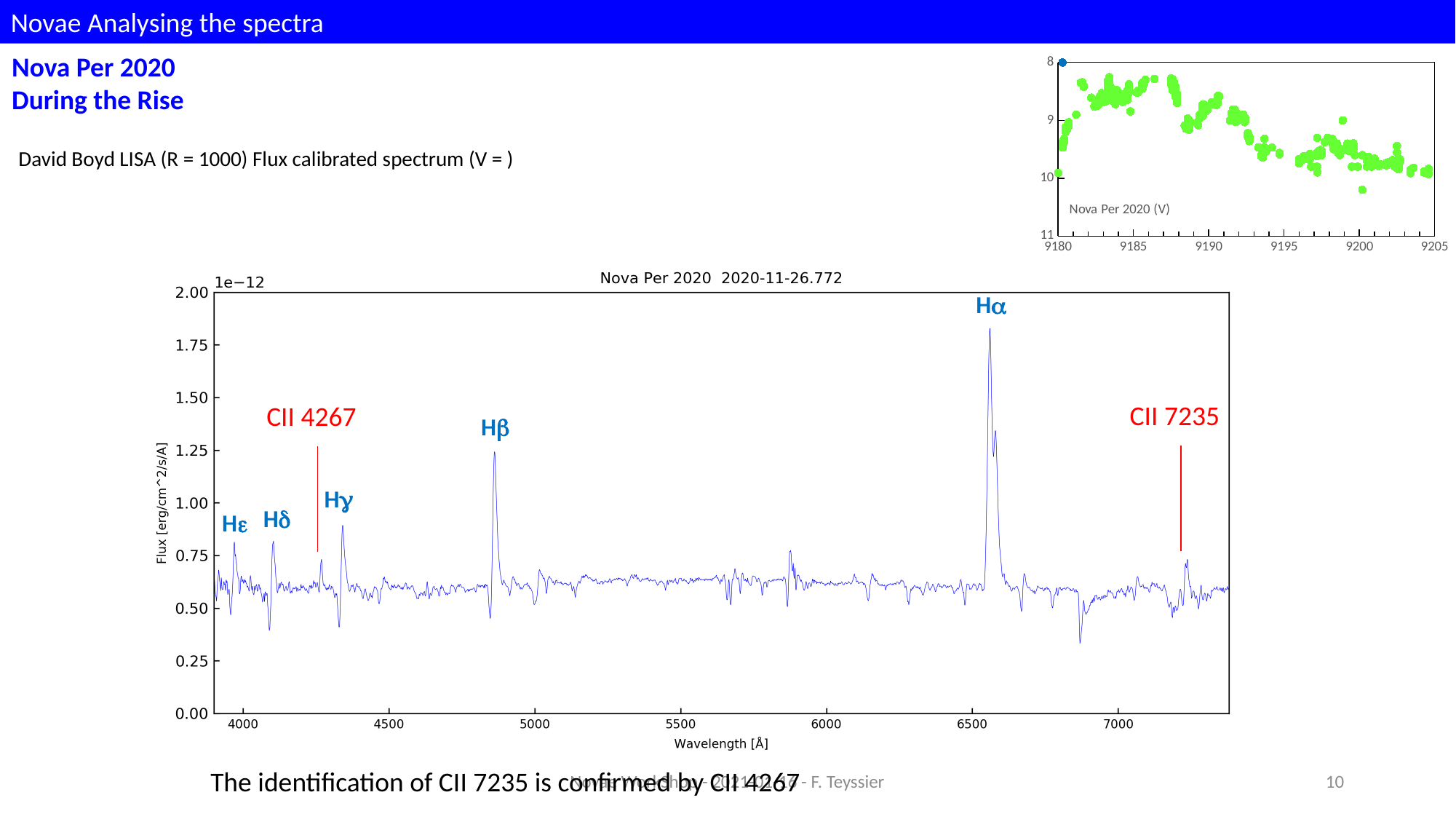
In the light curve chart in the top right, from x = 9185 to x = 9205, do the magnitude values increase or decrease? increase In the spectrum chart, is the peak flux of Hγ greater or less than 1.00 (×1e-12)? less What kind of chart is the small chart in the top right labelled 'Nova Per 2020 (V)'? scatter chart What kind of chart is the large chart titled 'Nova Per 2020 2020-11-26.772'? line chart What is the x-axis label of the spectrum chart? Wavelength [Å] In what colour are the CII 4267 and CII 7235 labels written on the spectrum chart? red In the spectrum chart, which labelled emission line has the highest peak? Hα In the spectrum chart, is the peak flux of Hα greater or less than 1.50 (×1e-12)? greater In the spectrum chart, which has the higher peak, Hβ or Hγ? Hβ In the spectrum chart, is the peak flux of Hβ greater or less than 1.00 (×1e-12)? greater How many hydrogen Balmer lines are labelled in blue on the spectrum chart? 5 In the spectrum chart, which has the higher peak, Hα or Hβ? Hα